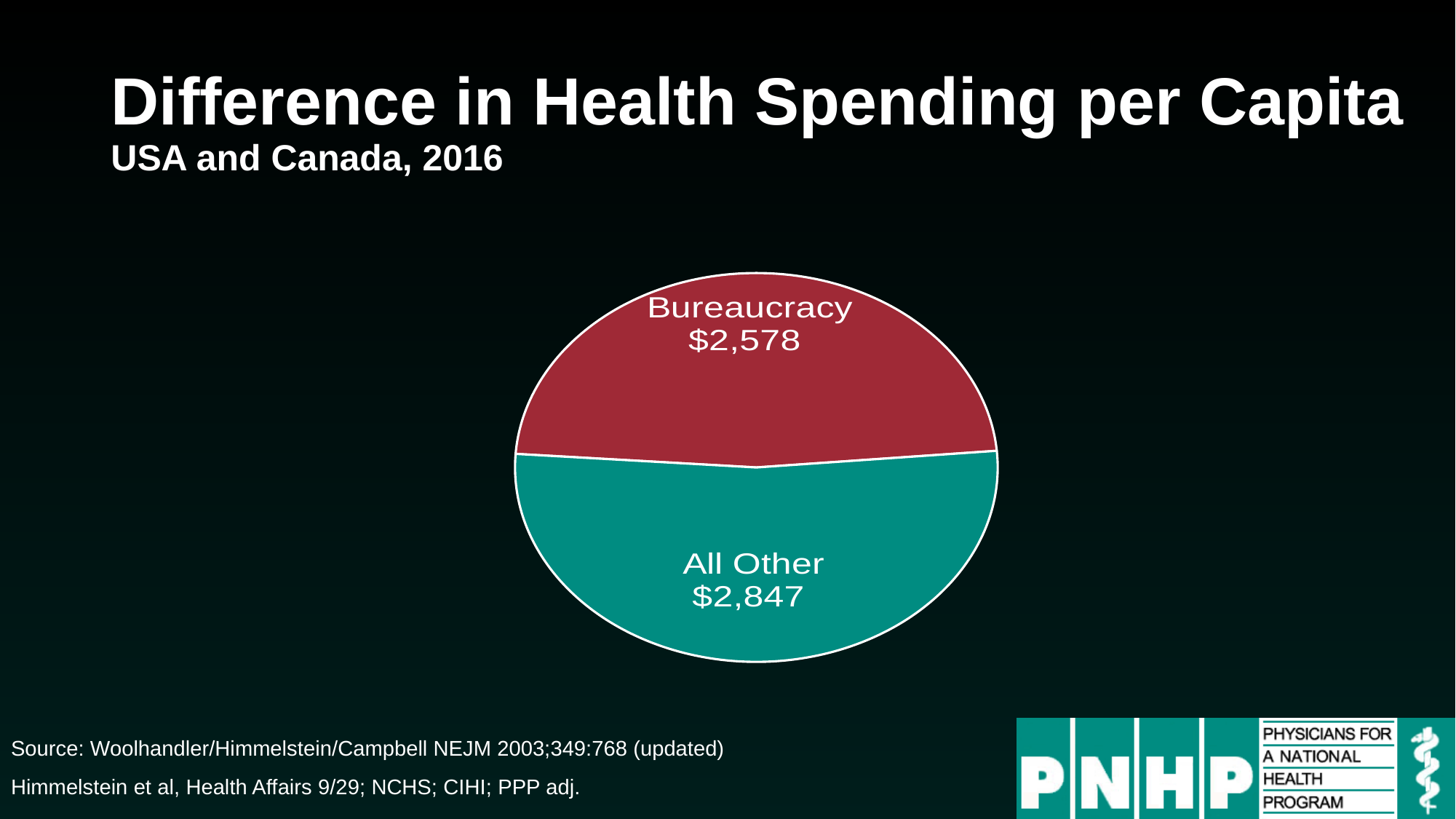
What is the value for All Other in the pie chart? $2,847 What is the title of the slide containing the pie chart? Difference in Health Spending per Capita What share of the pie does Bureaucracy represent, to one decimal place? 47.5% What colour is the Bureaucracy slice of the pie chart? red How many slices does the pie chart have? 2 What is the total of the two slices in the pie chart? $5,425 What type of chart is shown on the slide? pie chart Which slice of the pie chart is the smallest? Bureaucracy What is the difference between the All Other value and the Bureaucracy value? $269 Which slice of the pie chart is the largest? All Other What is the value for Bureaucracy in the pie chart? $2,578 Which is larger, Bureaucracy or All Other? All Other